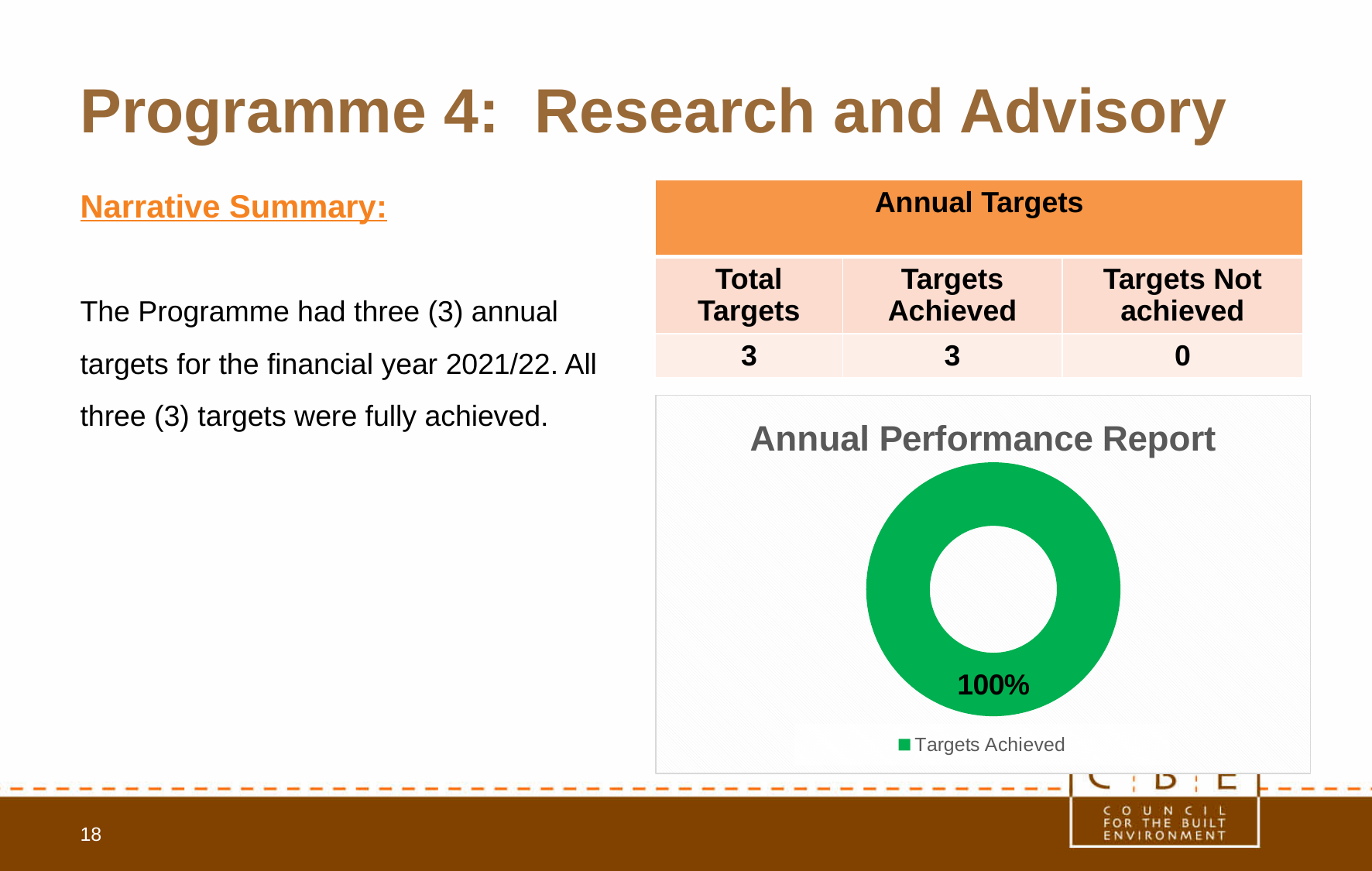
How many series does the legend of the Annual Performance Report chart list? 1 What value is shown for Targets Achieved in the Annual Performance Report chart? 100% Is the value for Targets Achieved in the Annual Performance Report chart greater or less than 50%? greater What is the title of the chart on the slide? Annual Performance Report How many slices are plotted in the Annual Performance Report chart? 1 What kind of chart is the Annual Performance Report chart? Doughnut chart What share of the Annual Performance Report doughnut does Targets Achieved take up? 100% What is the legend entry shown in the Annual Performance Report chart? Targets Achieved